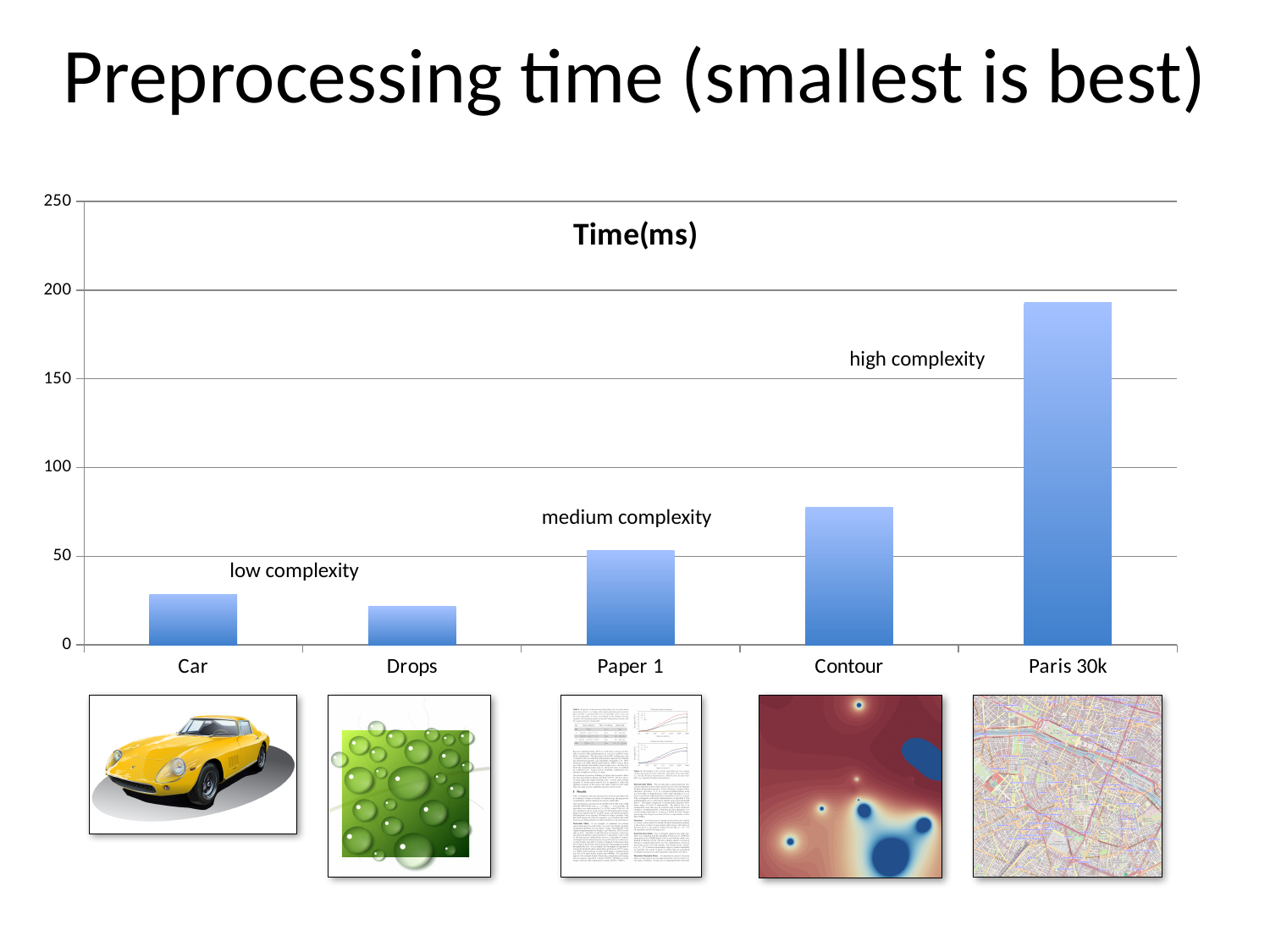
Is the value for Paper 1 greater or less than 50? greater Is the value for Contour greater or less than 100? less Which category has the lowest preprocessing time? Drops How many categories are plotted on the x axis of the chart? 5 What kind of chart is shown on the slide? bar chart Is the value for Paris 30k greater or less than 150? greater Which has a larger preprocessing time, Car or Drops? Car Which category has the highest preprocessing time? Paris 30k What is the title shown inside the chart area? Time(ms) Which complexity label is placed next to the Paris 30k bar? high complexity Which has a larger preprocessing time, Contour or Paper 1? Contour